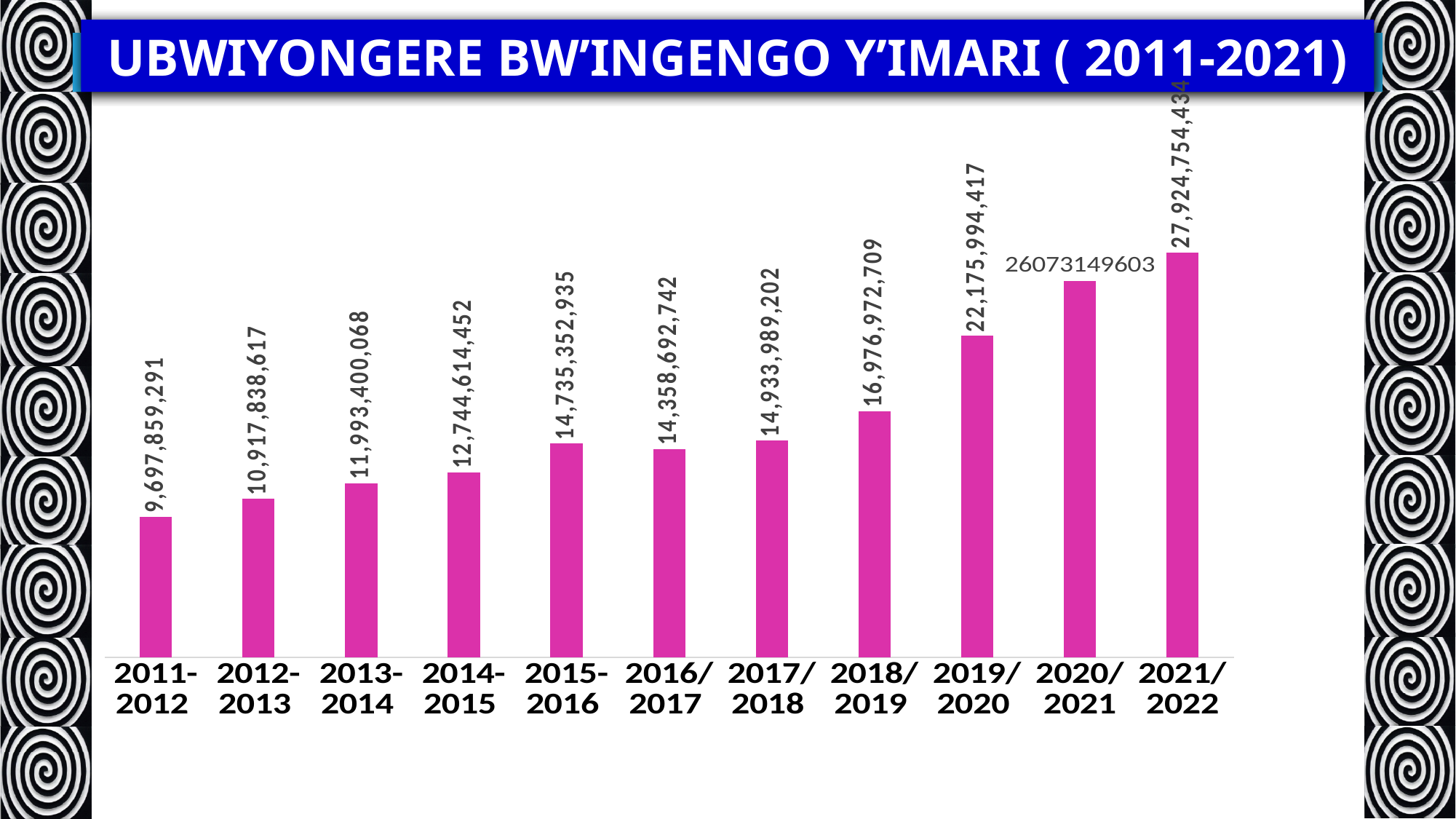
What is the difference between the values for 2012-2013 and 2011-2012? 1,219,979,326 Which period has the lowest value? 2011-2012 What kind of chart is shown on the slide? Bar chart What is the value for 2013-2014? 11,993,400,068 Which period has the highest value? 2021/2022 What is the value for 2020/2021? 26073149603 What is the value for 2011-2012? 9,697,859,291 Which is larger, the value for 2015-2016 or the value for 2016/2017? 2015-2016 What is the difference between the values for 2019/2020 and 2018/2019? 5,199,021,708 How many periods are shown on the x axis? 11 What is the value for 2018/2019? 16,976,972,709 What is the value for 2015-2016? 14,735,352,935